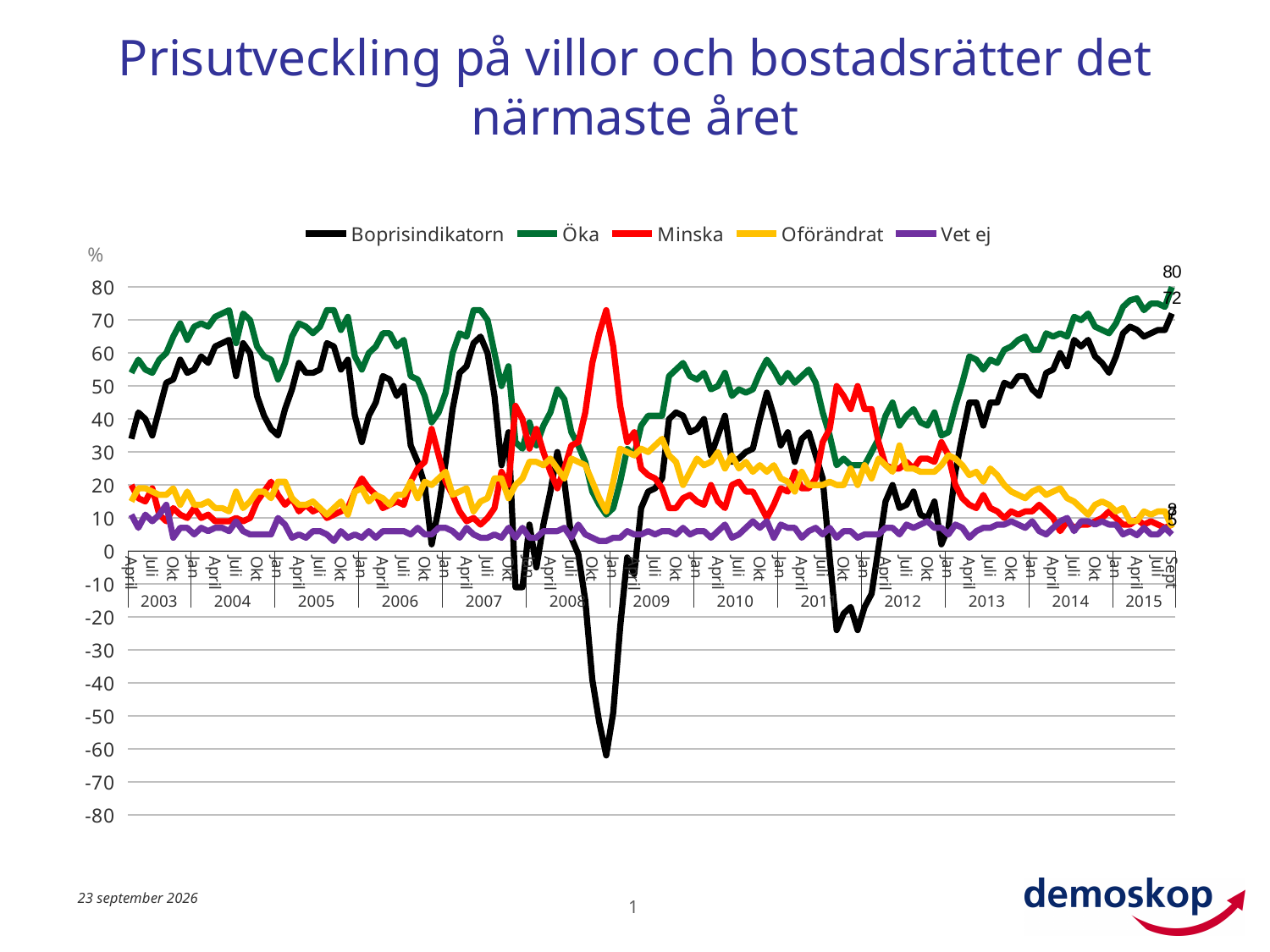
How many year labels are shown along the x axis? 13 Is the lowest value of the Boprisindikatorn series (around the start of 2009) greater or less than -50? less What is the final labelled value of the Öka series at the right end of the chart? 80 Which series has the highest value at the right end of the chart? Öka Is the peak value of the Minska series in early 2009 greater or less than 60? greater What is the difference between the final labelled values of Öka (80) and Boprisindikatorn (72)? 8 What kind of chart is shown on the slide? line chart How many series does the legend list? 5 What is the final labelled value of the Boprisindikatorn series at the right end of the chart? 72 Does the Öka series generally rise or fall from 2012 to 2015? rise At the right end of the chart, which is larger: Öka or Minska? Öka What colour is the Boprisindikatorn line in the legend? black